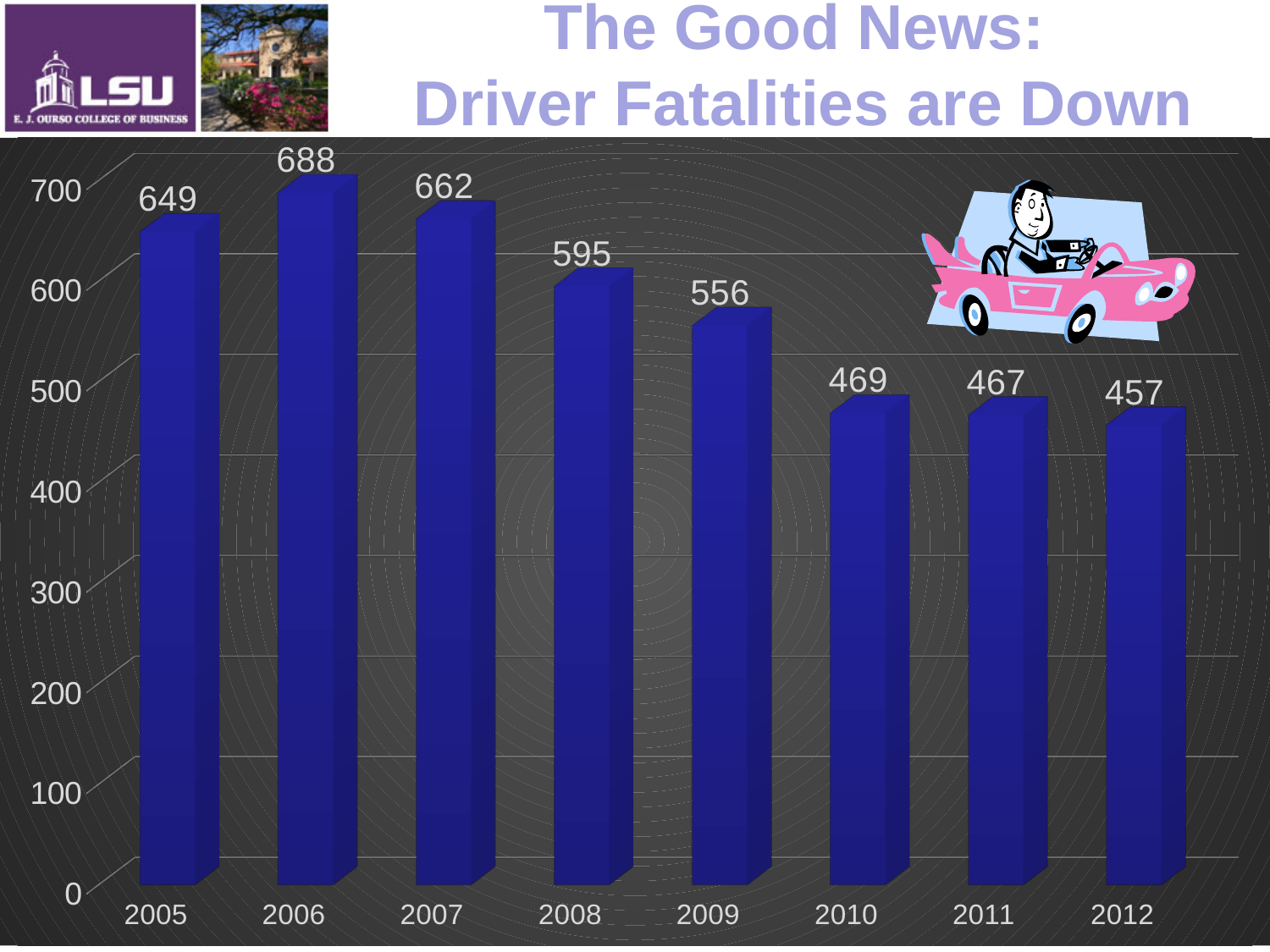
What is the difference between the values for 2007 and 2008? 67 Which is larger, the value for 2005 or the value for 2007? 2007 Do the values generally rise or fall from 2006 to 2012? fall What is the value for 2012? 457 Which year has the highest value? 2006 Is the value for 2010 greater or less than 500? less What is the difference between the values for 2006 and 2012? 231 Which year has the lowest value? 2012 What is the value for 2005? 649 What is the value for 2009? 556 What kind of chart is shown on the slide? bar chart How many years are shown on the x axis? 8